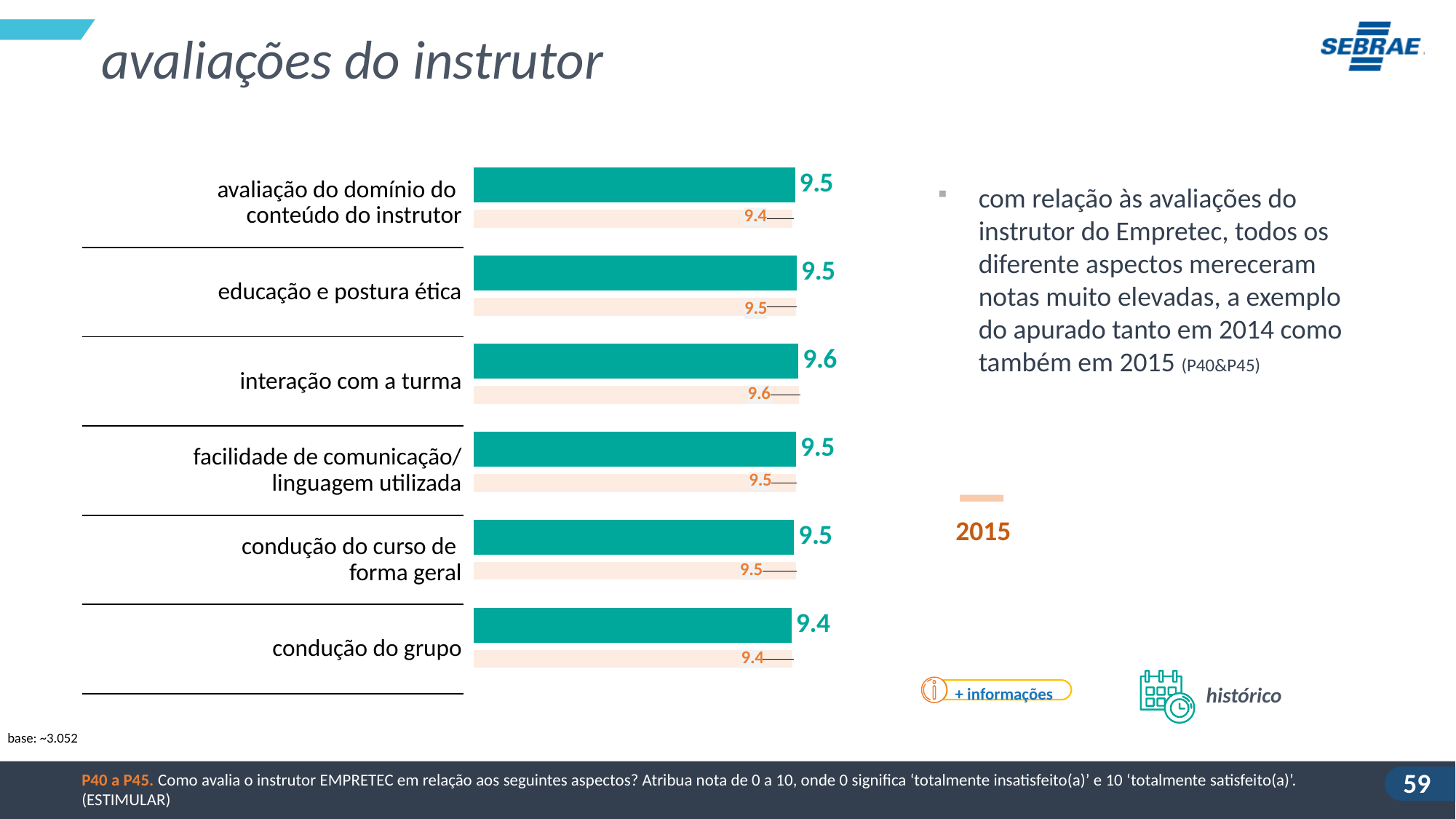
Which category has the highest value in the teal series? interação com a turma In the teal series, which is larger: "interação com a turma" or "condução do grupo"? interação com a turma Which category has the highest 2015 value? interação com a turma What is the 2015 value for "avaliação do domínio do conteúdo do instrutor"? 9.4 What is the 2015 value for "condução do grupo"? 9.4 For "avaliação do domínio do conteúdo do instrutor", what is the difference between the teal bar value and the 2015 value? 0.1 What type of chart is shown on the slide? bar chart What is the value of the teal bar for "educação e postura ética"? 9.5 Which category has the lowest value in the teal series? condução do grupo In the teal series, what is the difference between "interação com a turma" and "condução do grupo"? 0.2 What is the value of the teal bar for "interação com a turma"? 9.6 How many categories (aspects) are shown in the chart? 6